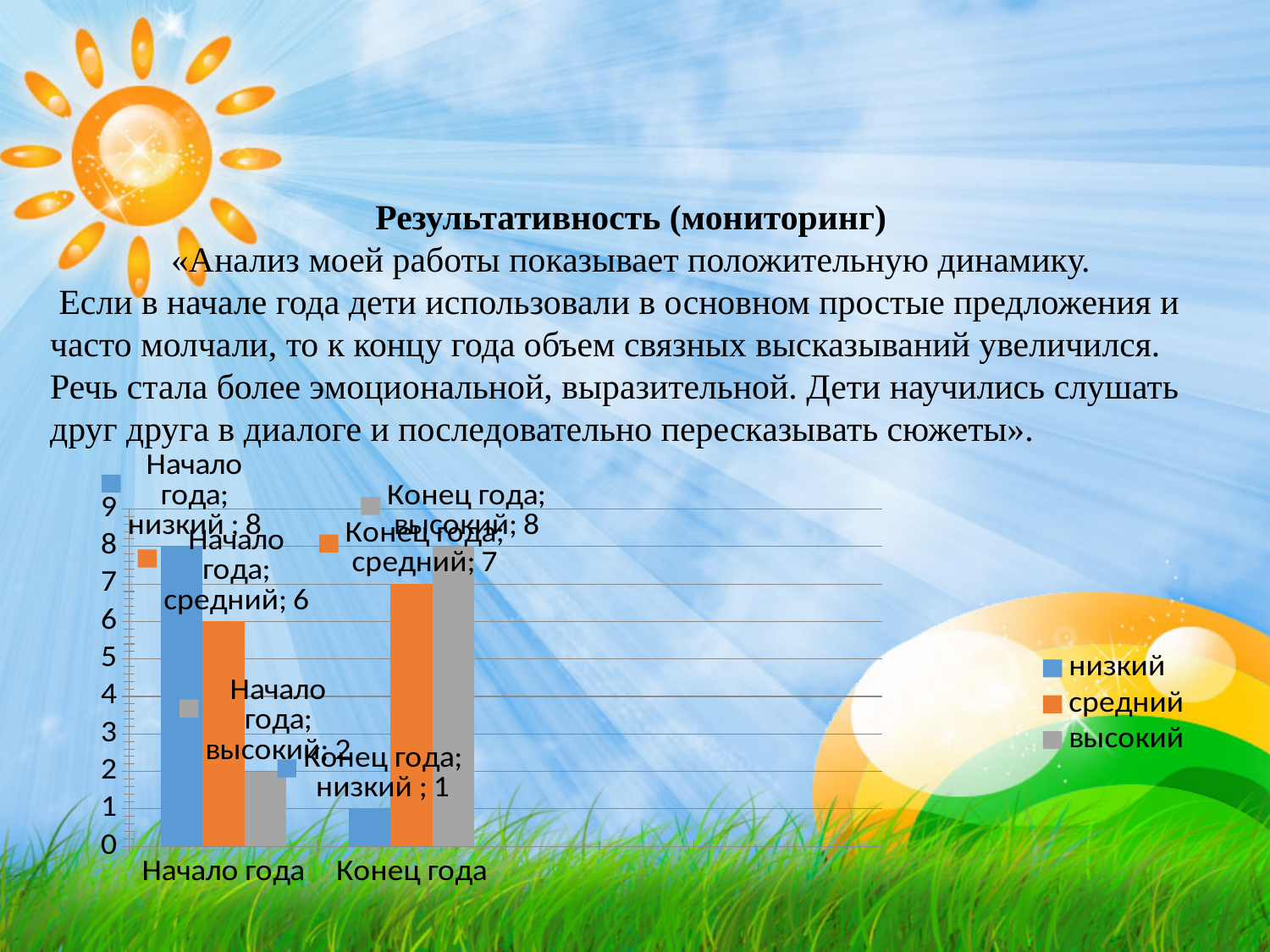
What is the value for высокий at Конец года? 8 Which series has the highest value at Конец года? высокий What is the value for низкий at Конец года? 1 What is the value for средний at Начало года? 6 What is the value for высокий at Начало года? 2 What is the value for низкий at Начало года? 8 How many series does the legend list? 3 What kind of chart is shown on the slide? bar chart What is the value for средний at Конец года? 7 What is the difference between the высокий values at Конец года and Начало года? 6 Which series has the lowest value at Начало года? высокий Which is larger: низкий at Начало года or низкий at Конец года? низкий at Начало года